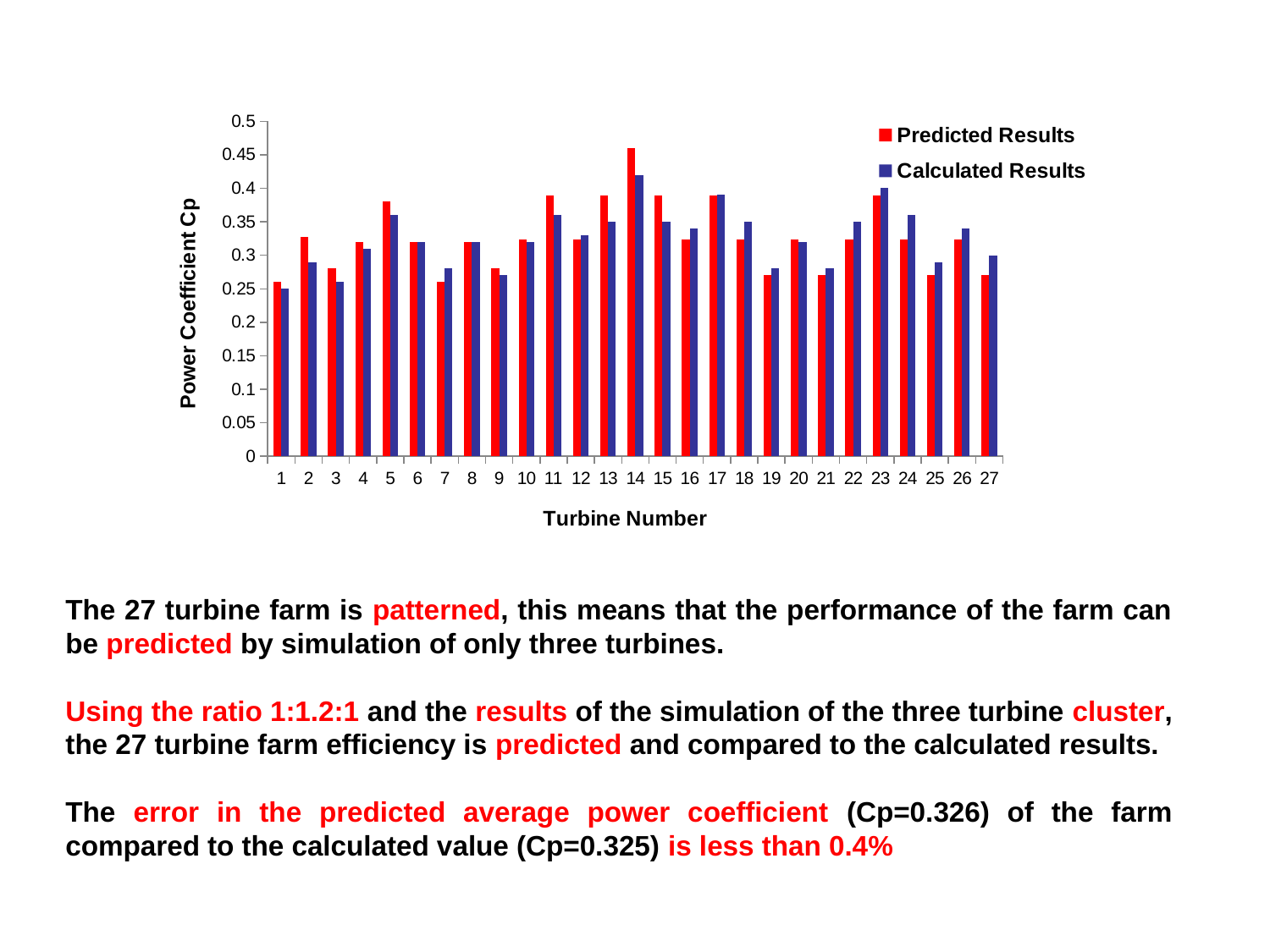
Is the Calculated Results value for turbine 23 greater or less than 0.35? greater Which turbine number has the highest Predicted Results value? 14 For turbine 14, which is larger: the Predicted Results value or the Calculated Results value? Predicted Results What kind of chart is shown on the slide? bar chart How many turbine numbers are shown on the x axis? 27 Is the Predicted Results value for turbine 1 greater or less than 0.3? less Is the Calculated Results value for turbine 1 greater or less than 0.3? less For turbine 18, which is larger: the Predicted Results value or the Calculated Results value? Calculated Results What is the title of the vertical axis of the chart? Power Coefficient Cp How many series does the legend list? 2 Which turbine number has the highest Calculated Results value? 14